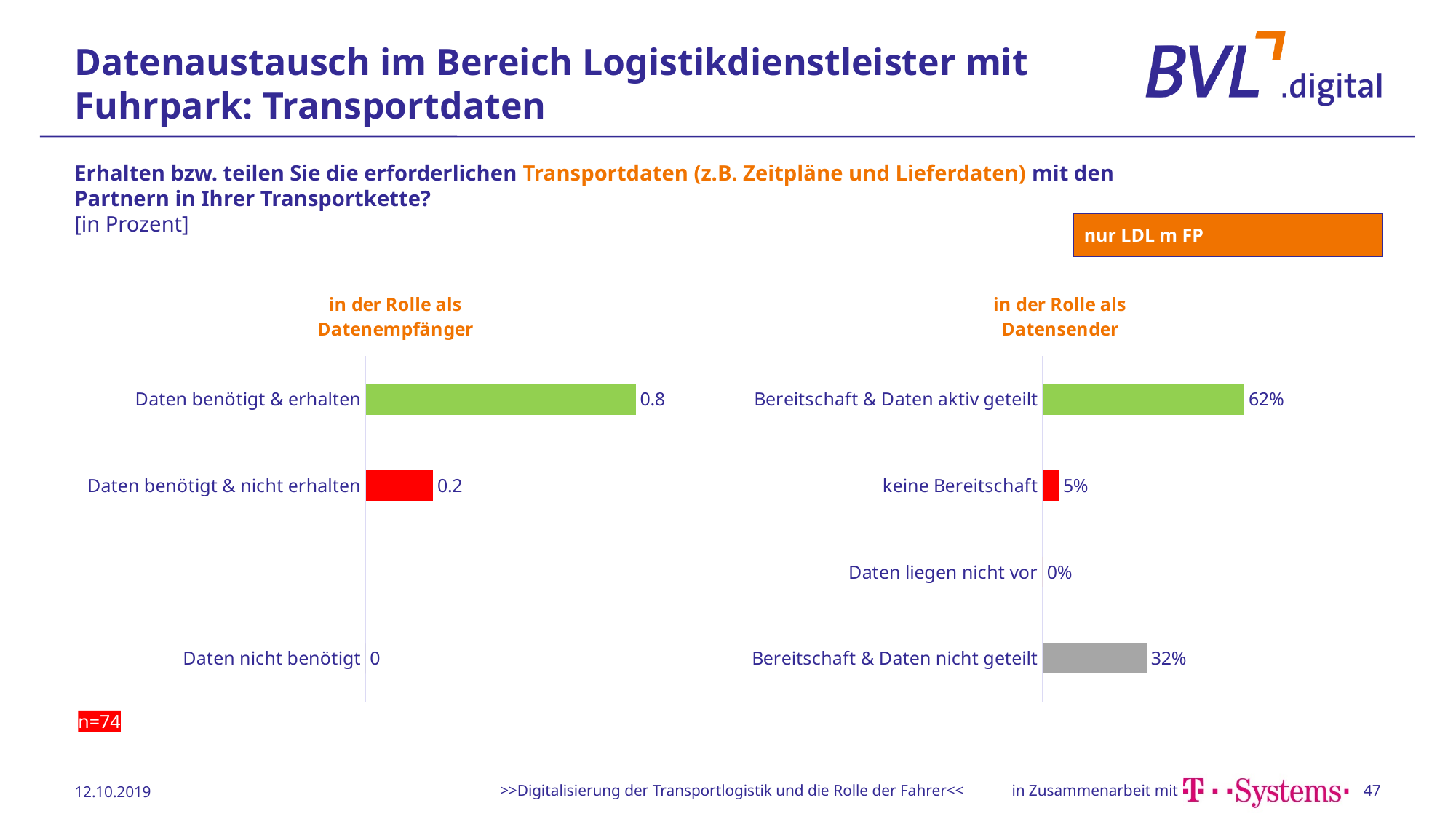
What kind of chart is the 'in der Rolle als Datensender' chart? bar chart In the 'in der Rolle als Datenempfänger' chart, how many categories are shown? 3 In the 'in der Rolle als Datensender' chart, what is the value for 'Bereitschaft & Daten aktiv geteilt'? 62% In the 'in der Rolle als Datenempfänger' chart, what is the difference between 'Daten benötigt & erhalten' and 'Daten benötigt & nicht erhalten'? 0.6 In the 'in der Rolle als Datensender' chart, how many categories are shown? 4 In the 'in der Rolle als Datensender' chart, what is the difference between 'Bereitschaft & Daten aktiv geteilt' and 'Bereitschaft & Daten nicht geteilt'? 30% In the 'in der Rolle als Datensender' chart, which category has the lowest value? Daten liegen nicht vor In the 'in der Rolle als Datensender' chart, what is the value for 'Bereitschaft & Daten nicht geteilt'? 32% In the 'in der Rolle als Datenempfänger' chart, what is the value for 'Daten benötigt & erhalten'? 0.8 In the 'in der Rolle als Datenempfänger' chart, which category has the highest value? Daten benötigt & erhalten In the 'in der Rolle als Datenempfänger' chart, what is the value for 'Daten benötigt & nicht erhalten'? 0.2 In the 'in der Rolle als Datensender' chart, what is the value for 'keine Bereitschaft'? 5%